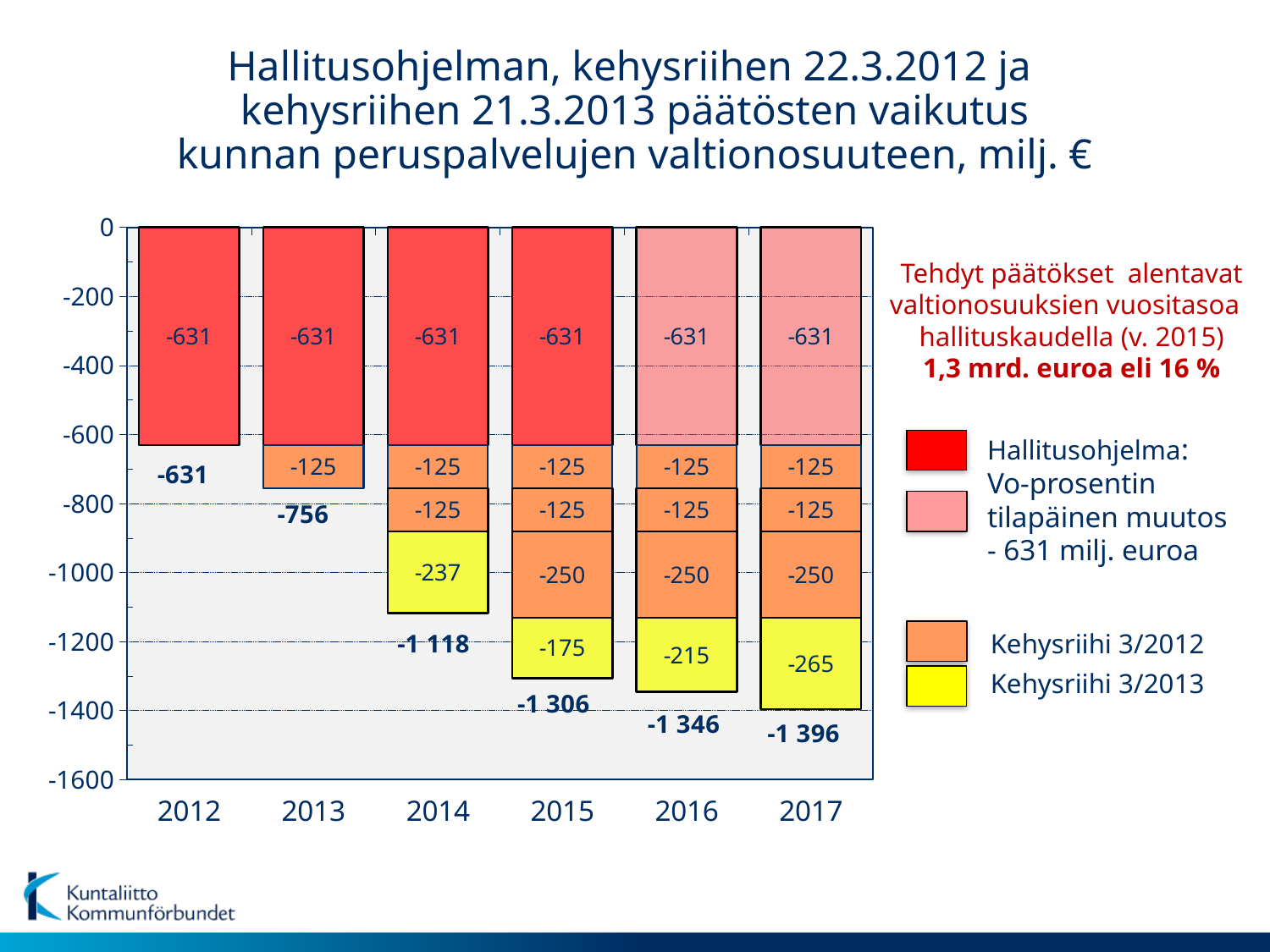
What is the value of the Kehysriihi 3/2013 (yellow) segment in 2016? -215 Is the total for 2014 greater or less than -1000? less What kind of chart is shown on the slide? Stacked bar chart What is the difference between the total for 2017 and the total for 2016? 50 Do the total values rise or fall from 2012 to 2017? Fall What is the total value shown for the 2015 bar? -1 306 What is the value of the Kehysriihi 3/2013 (yellow) segment in 2014? -237 How many years are shown on the x axis? 6 Which year has the smallest total reduction? 2012 Which year has the largest total reduction (the lowest total)? 2017 What is the total value shown for the 2017 bar? -1 396 What is the value of the Hallitusohjelma segment in 2012? -631